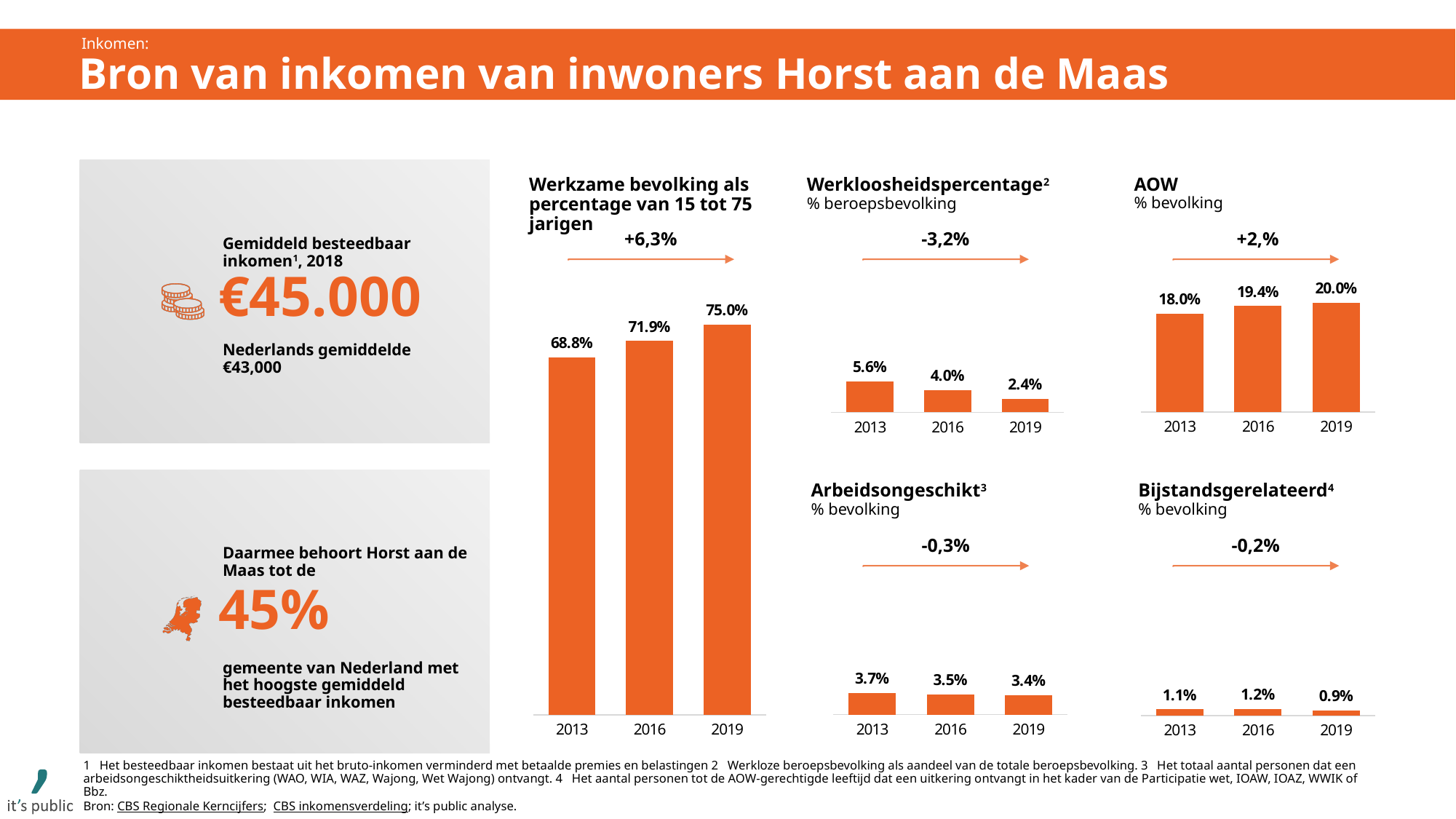
In the 'Arbeidsongeschikt' chart, which year has the highest value? 2013 In the 'Arbeidsongeschikt' chart, what is the value for 2019? 3.4% In the 'AOW' chart, do the values rise or fall from 2013 to 2019? rise How many years are shown in the 'Werkloosheidspercentage' chart? 3 In the 'Bijstandsgerelateerd' chart, what is the value for 2016? 1.2% In the 'Werkloosheidspercentage' chart, what is the value for 2013? 5.6% In the 'AOW' chart, what is the value for 2016? 19.4% In the 'Werkzame bevolking als percentage van 15 tot 75 jarigen' chart, what is the value for 2019? 75.0% What kind of chart is the 'AOW' chart? bar chart In the 'Werkzame bevolking als percentage van 15 tot 75 jarigen' chart, which year has the lowest value? 2013 In the 'Bijstandsgerelateerd' chart, which is larger, the value for 2013 or the value for 2019? 2013 In the 'Werkloosheidspercentage' chart, what is the difference between the 2013 and 2019 values? 3.2%